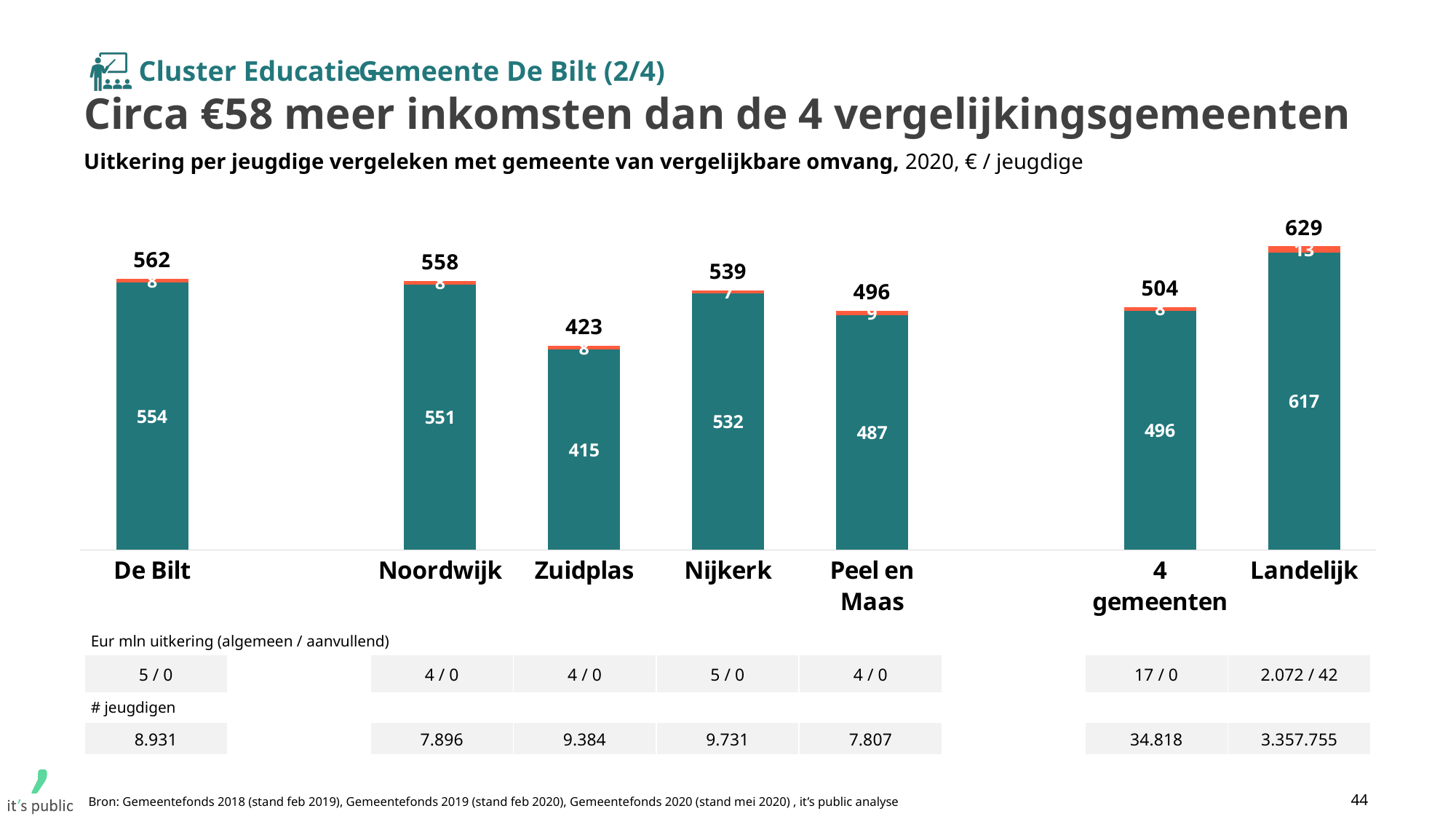
What is the difference between the total for De Bilt and the total for 4 gemeenten? 58 What is the total value shown above the bar for De Bilt? 562 What is the total value shown above the bar for Peel en Maas? 496 What is the value of the teal (lower) segment for Zuidplas? 415 What is the value of the teal (lower) segment for Landelijk? 617 What is the value of the teal (lower) segment for Nijkerk? 532 What kind of chart is shown on the slide? Stacked bar chart What is the total value shown above the bar for Landelijk? 629 How many categories (bars) are shown in the chart? 7 Which category has the lowest total value? Zuidplas Which has a larger total value, Noordwijk or Peel en Maas? Noordwijk Which category has the highest total value? Landelijk